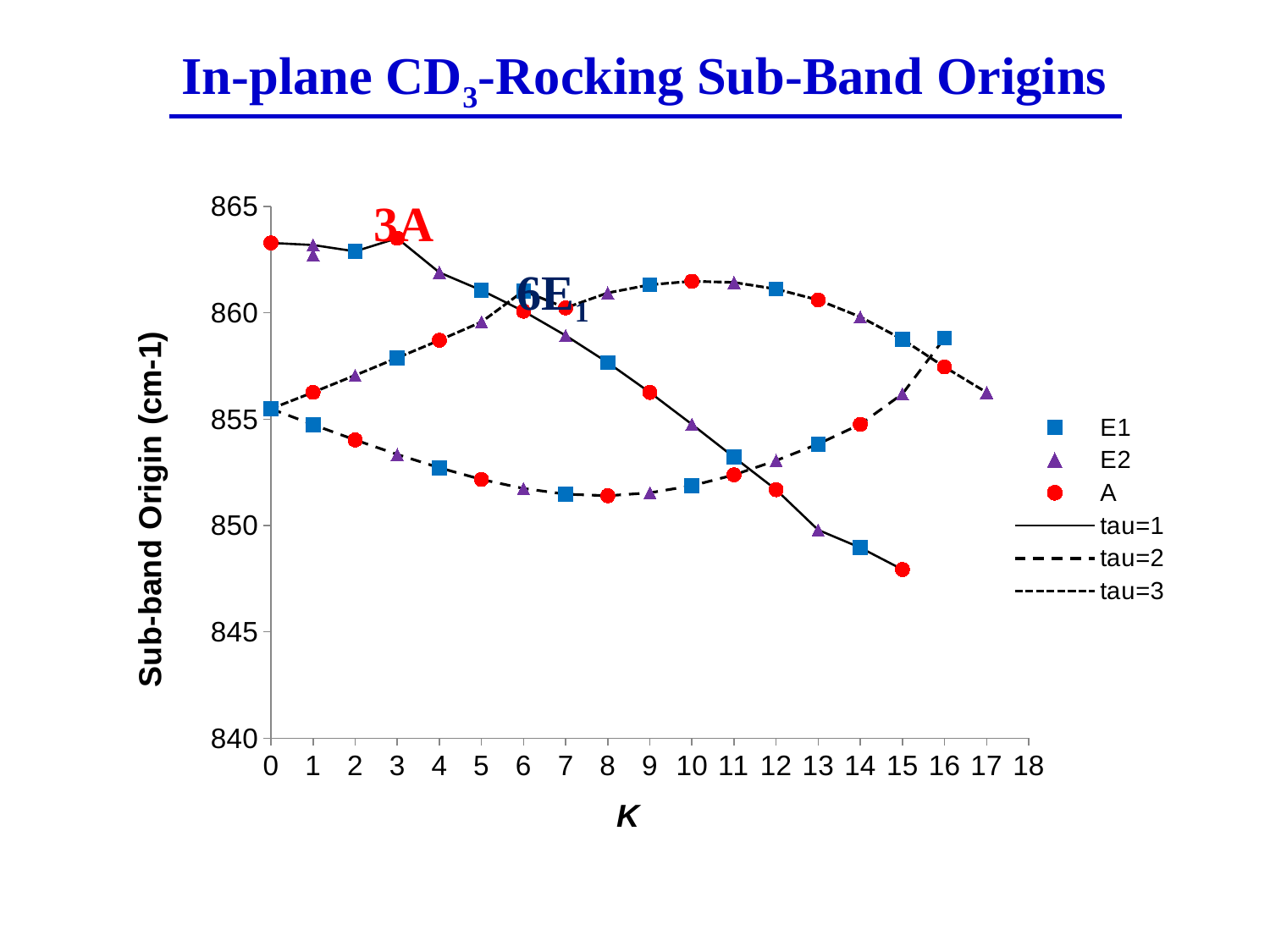
At which value of K does the lowest point on the chart occur? 15 What kind of chart is shown on the slide? line chart with markers (scatter plot) How many data points are plotted on the tau=1 curve? 16 Is the value of the tau=3 curve at K=10 greater or less than 860? greater Does the tau=1 curve rise or fall as K increases? fall What is the title of the chart? In-plane CD3-Rocking Sub-Band Origins What is the label of the vertical axis? Sub-band Origin (cm-1) How many entries does the legend list? 6 At K=10, which curve has the larger value, tau=3 or tau=2? tau=3 Is the value of the tau=2 curve at K=7 greater or less than 850? greater Is the value of the tau=1 curve at K=0 greater or less than 860? greater